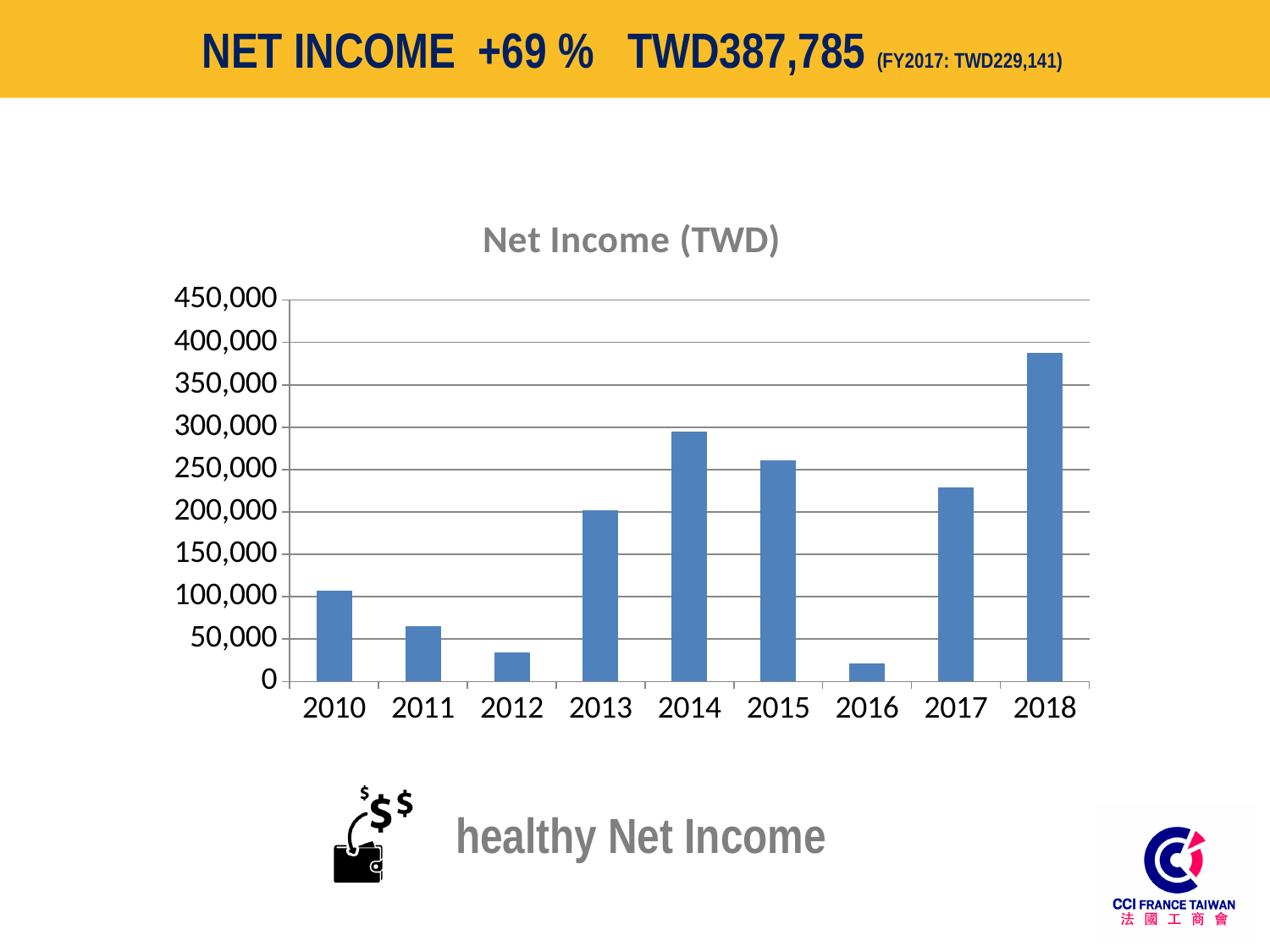
By how much did net income increase from 2017 to 2018, based on the values stated on the slide? TWD158,644 How many years are plotted on the chart? 9 Do the values rise or fall from 2010 to 2012? fall Is the value for 2015 greater or less than 300,000? less What is the net income for 2018, as stated on the slide? TWD387,785 What is the net income for FY2017, as stated on the slide? TWD229,141 Is the value for 2012 greater or less than 50,000? less Which year has the highest net income? 2018 What type of chart is shown on the slide? bar chart What is the title of the chart? Net Income (TWD) Which year has the lowest net income? 2016 Which year has the larger net income, 2014 or 2015? 2014